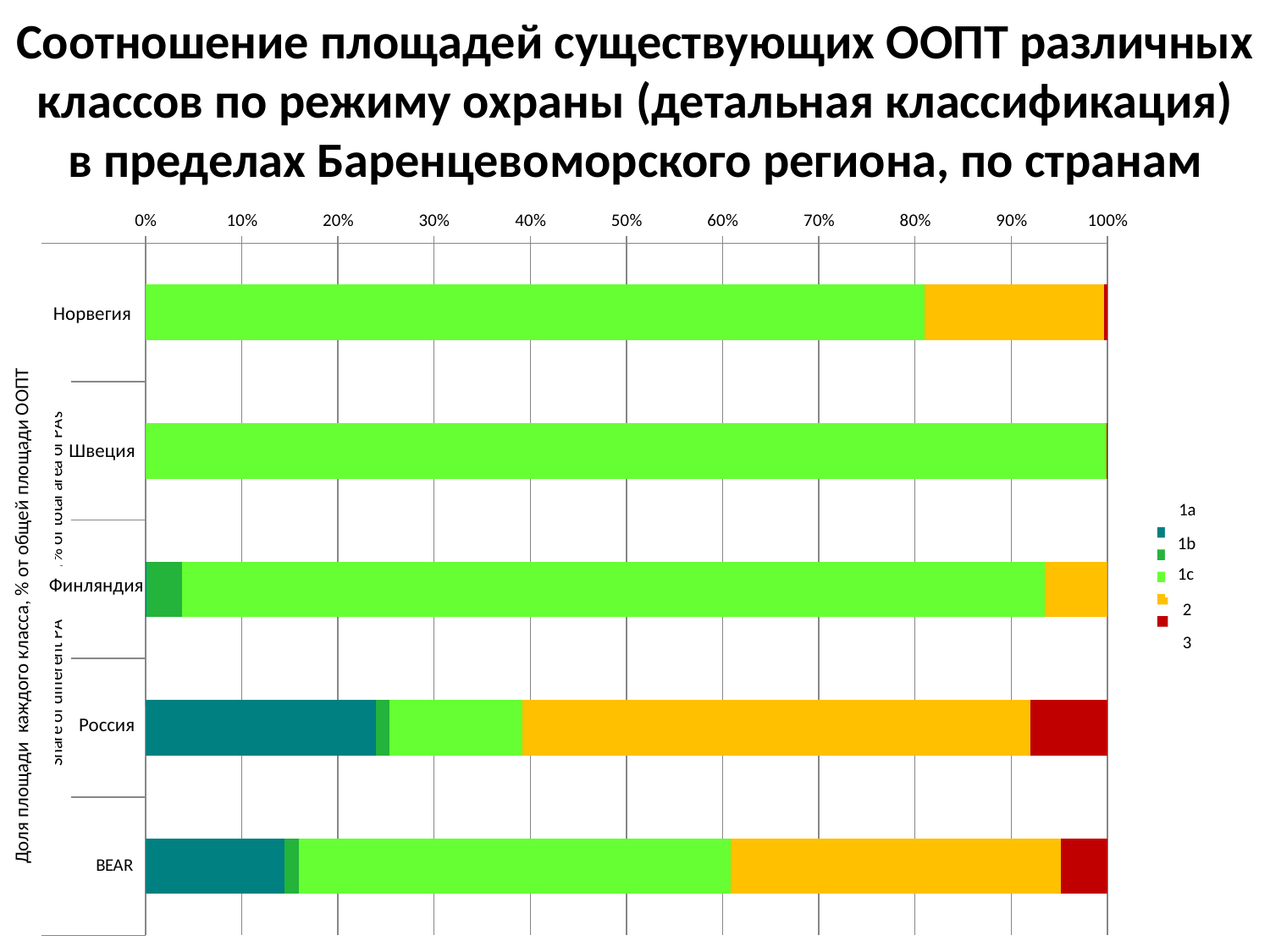
Is the share of class 1a for Россия greater or less than 20%? greater How many series does the legend list? 5 Which country has the largest share of class 1a? Россия Is the share of class 1c for Швеция greater or less than 90%? greater Is the share of class 1a for BEAR greater or less than 20%? less What kind of chart is shown on the slide? stacked bar chart What are the legend entries of the chart? 1a, 1b, 1c, 2, 3 Which is larger: the share of class 2 for Норвегия or for Финляндия? Норвегия How many countries/regions are listed on the vertical axis of the chart? 5 Which is larger: the share of class 1a for Россия or for BEAR? Россия Which country has the largest share of class 2? Россия